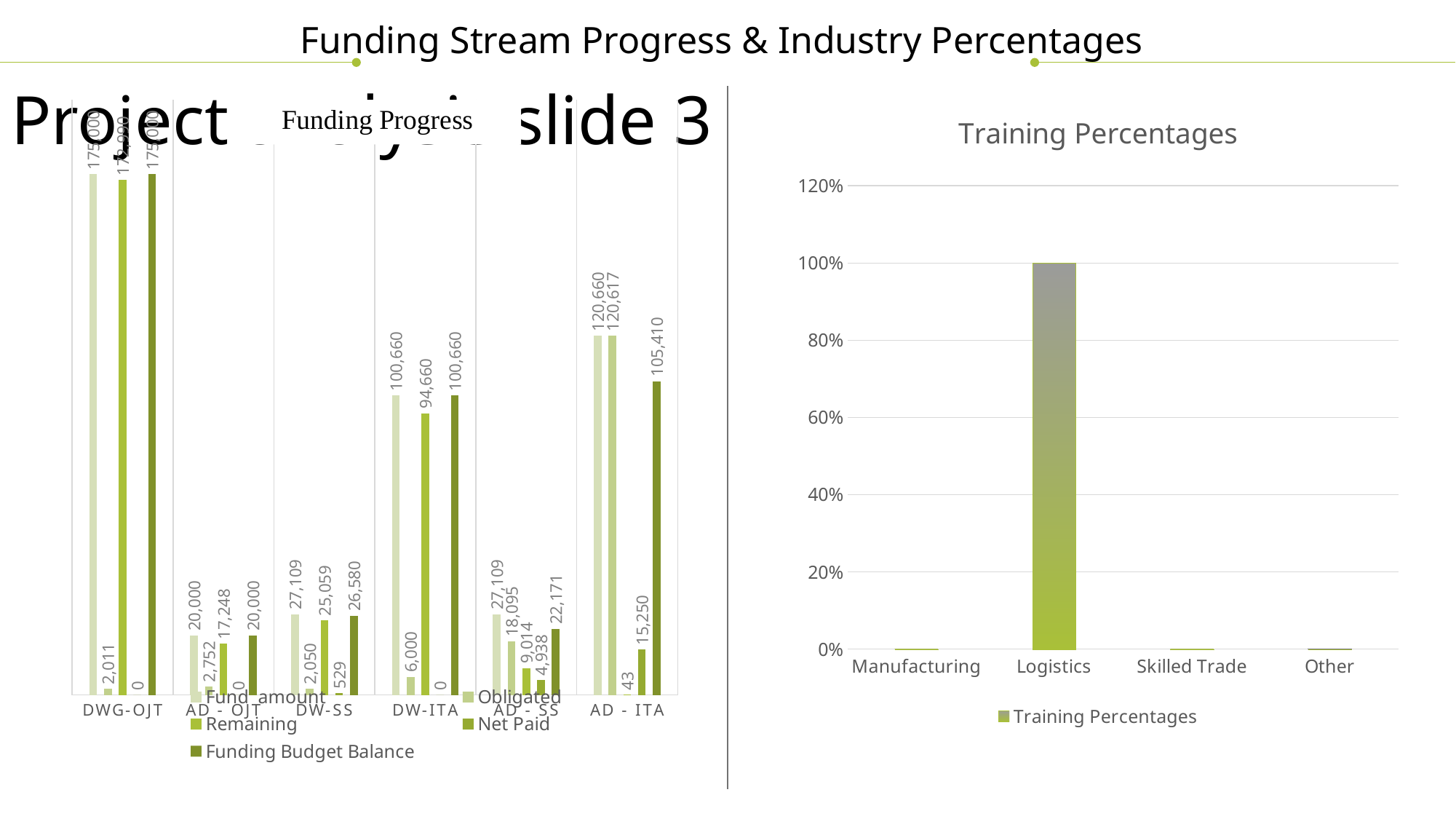
In the Funding Progress chart, what is the Obligated value for AD - OJT? 2,752 In the Funding Progress chart, what is the difference between the Fund_amount and the Remaining value for AD - OJT? 2,752 How many series does the legend of the Funding Progress chart list? 5 In the Funding Progress chart, which category has the highest Net Paid value? AD - ITA In the Funding Progress chart, is the Obligated value larger for AD - SS or for DW-SS? AD - SS In the Funding Progress chart, what is the Fund_amount value for DW-ITA? 100,660 In the Funding Progress chart, what is the Net Paid value for AD - ITA? 15,250 How many categories are shown on the x axis of the Training Percentages chart? 4 In the Funding Progress chart, what is the Remaining value for AD - SS? 9,014 In the Funding Progress chart, what is the Funding Budget Balance for DW-SS? 26,580 In the Training Percentages chart, what is the value for Logistics? 100% What kind of chart is the Training Percentages chart? Bar chart